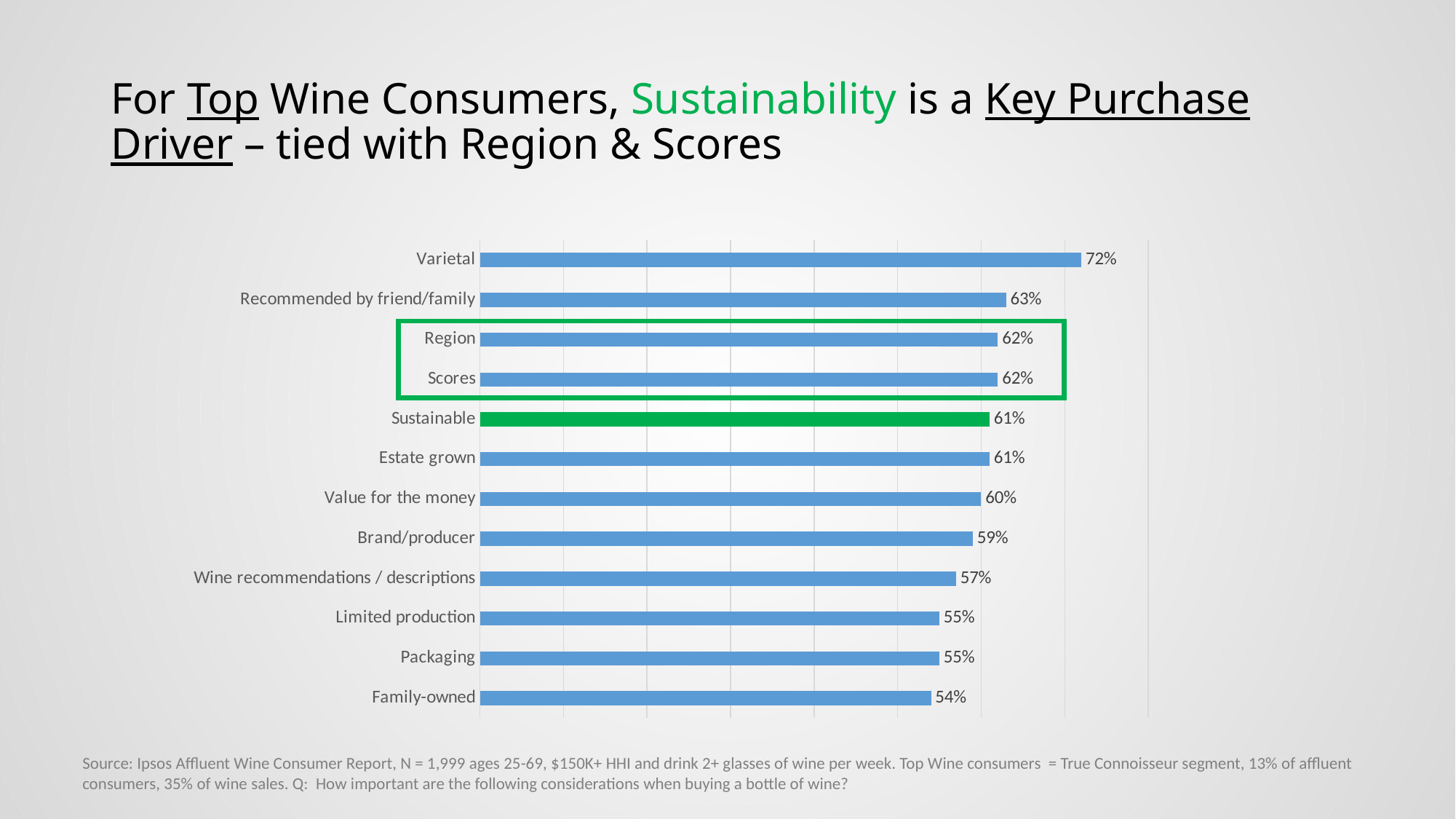
How many categories are shown in the chart? 12 Which category has the highest value? Varietal Which is larger, the value for Brand/producer or the value for Limited production? Brand/producer What is the value for Sustainable? 61% Which category has the lowest value? Family-owned What is the difference between the values for Recommended by friend/family and Family-owned? 9% What is the value for Recommended by friend/family? 63% What kind of chart is shown on the slide? Bar chart What is the difference between the values for Varietal and Sustainable? 11% What is the value for Family-owned? 54% What is the value for Varietal? 72% Which bar is coloured green rather than blue? Sustainable